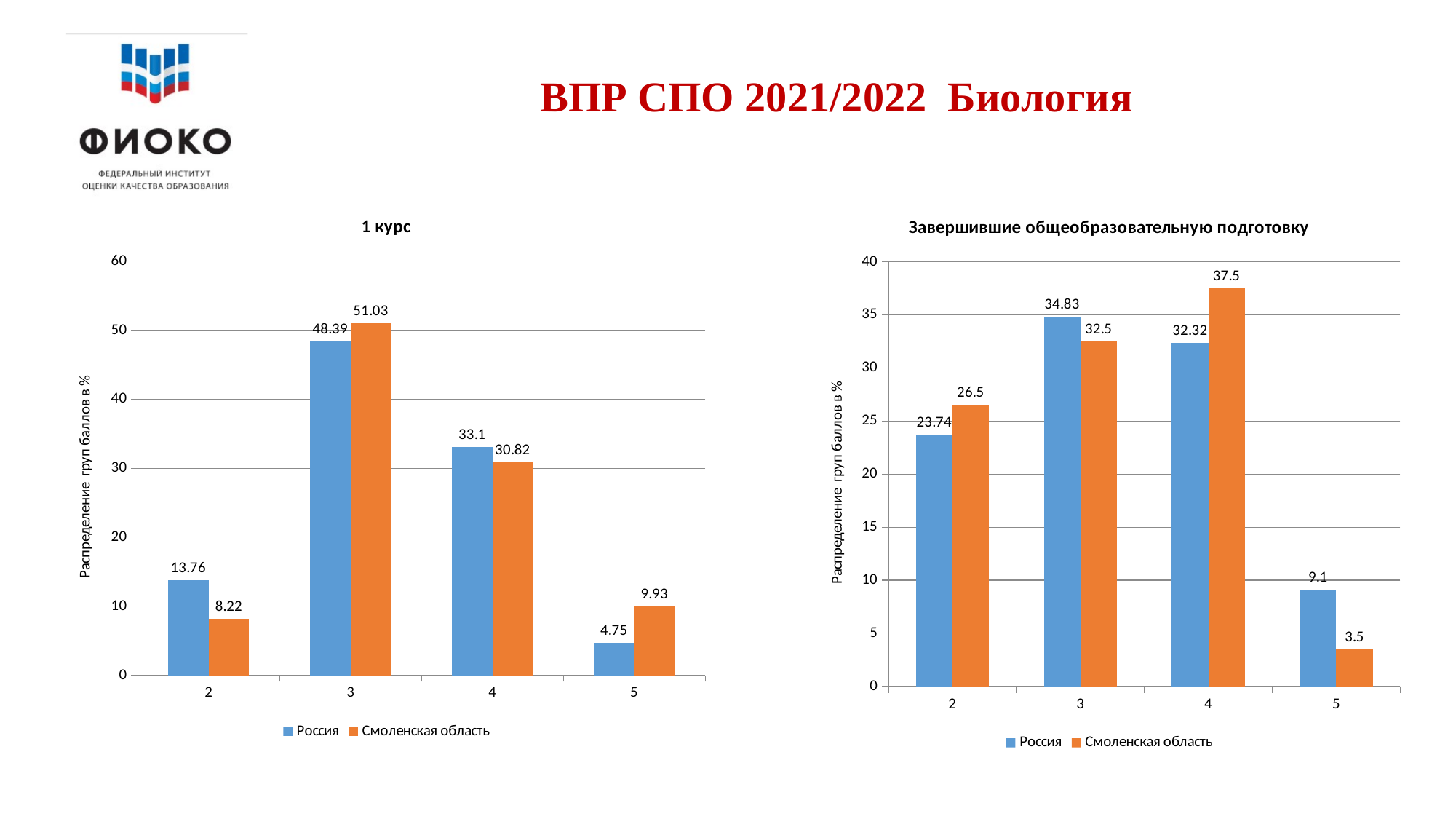
How many series does the legend of the '1 курс' chart list? 2 In the 'Завершившие общеобразовательную подготовку' chart, what is the value for Россия at category 2? 23.74 In the 'Завершившие общеобразовательную подготовку' chart, which category has the lowest value for Смоленская область? 5 In the 'Завершившие общеобразовательную подготовку' chart, what is the value for Смоленская область at category 4? 37.5 In the '1 курс' chart, what is the value for Смоленская область at category 5? 9.93 In the '1 курс' chart, what is the value for Россия at category 3? 48.39 In the 'Завершившие общеобразовательную подготовку' chart, what is the difference between Россия and Смоленская область at category 5? 5.6 In the '1 курс' chart, what is the difference between Россия and Смоленская область at category 2? 5.54 In the '1 курс' chart, which category has the highest value for Смоленская область? 3 What type of chart is the 'Завершившие общеобразовательную подготовку' chart? Bar chart In the '1 курс' chart, which series has the larger value at category 4, Россия or Смоленская область? Россия In the '1 курс' chart, which category has the lowest value for Россия? 5